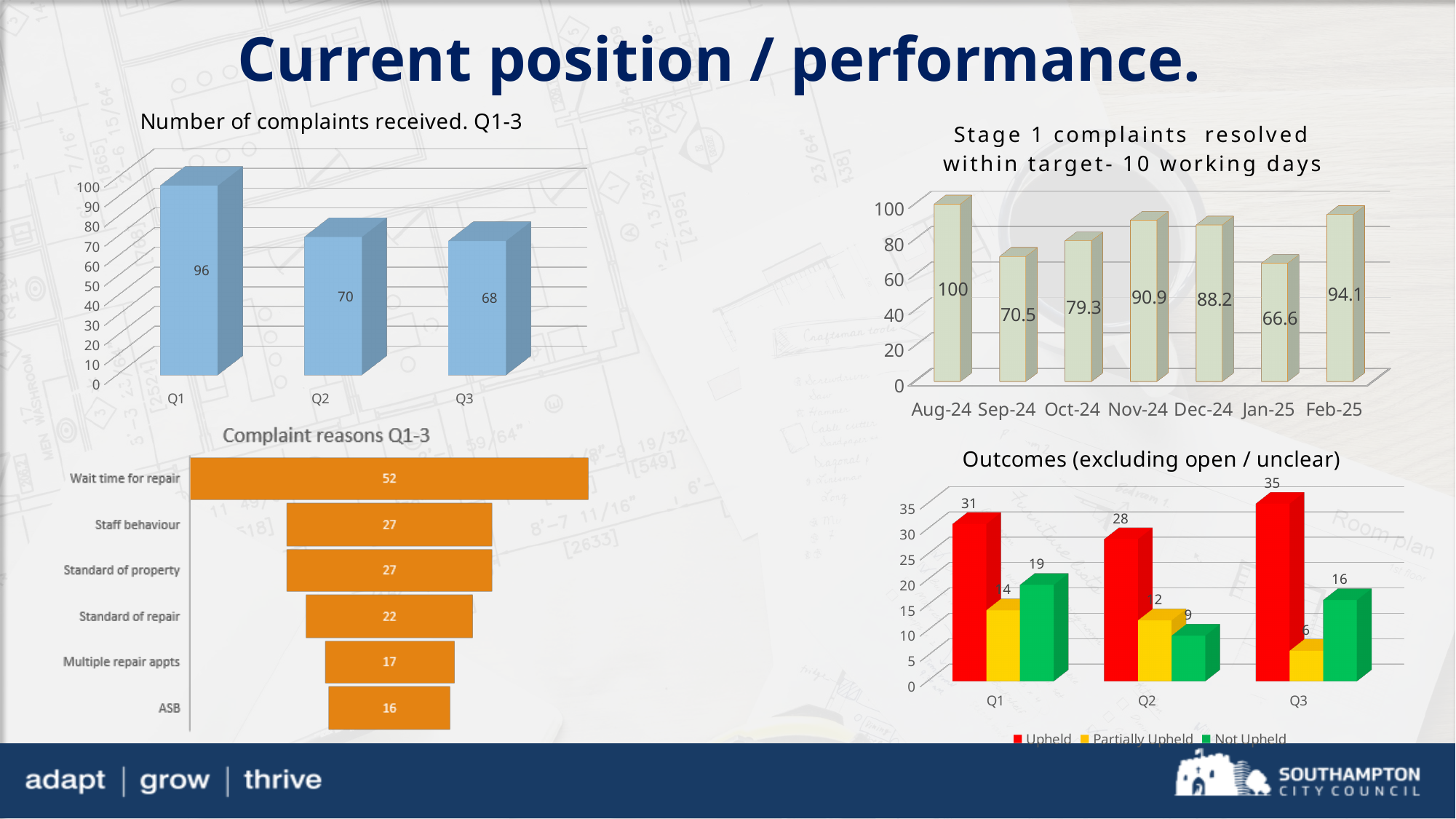
In the 'Outcomes (excluding open / unclear)' chart, what is the Not Upheld value for Q3? 16 In the 'Number of complaints received. Q1-3' chart, how many complaints were received in Q1? 96 In the 'Stage 1 complaints resolved within target- 10 working days' chart, which month has the lowest value? Jan-25 In the 'Outcomes (excluding open / unclear)' chart, what is the difference between Upheld in Q3 and Upheld in Q2? 7 In the 'Complaint reasons Q1-3' chart, what is the value for Multiple repair appts? 17 In the 'Complaint reasons Q1-3' chart, which is larger: Standard of repair or ASB? Standard of repair In the 'Complaint reasons Q1-3' chart, which reason has the highest value? Wait time for repair In the 'Stage 1 complaints resolved within target- 10 working days' chart, what is the value for Nov-24? 90.9 How many months are shown in the 'Stage 1 complaints resolved within target- 10 working days' chart? 7 In the 'Number of complaints received. Q1-3' chart, what is the difference between Q1 and Q3? 28 What type of chart is the 'Complaint reasons Q1-3' chart? Bar chart How many series does the legend list in the 'Outcomes (excluding open / unclear)' chart? 3